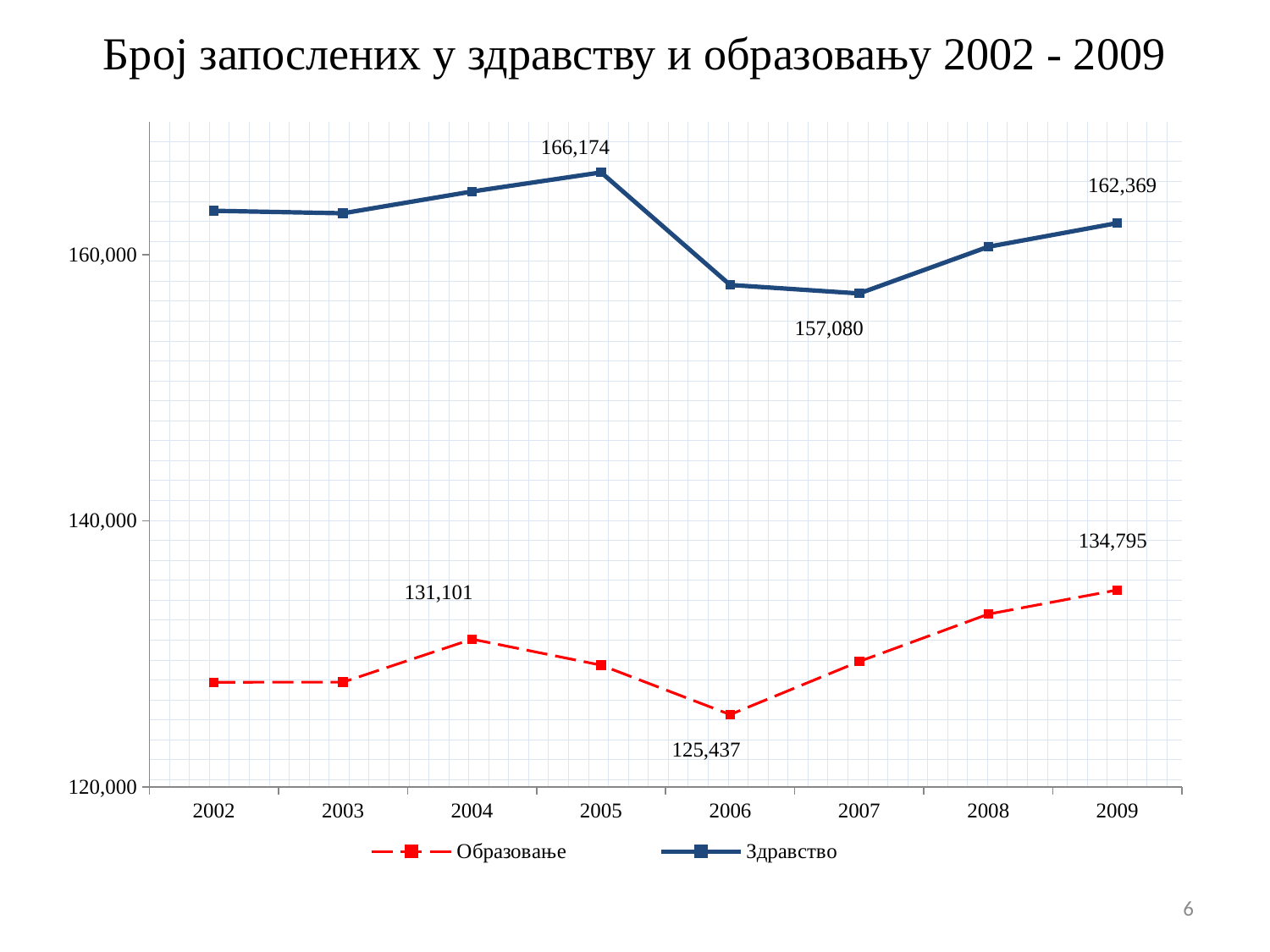
How many series does the legend list? 2 What is the value for Здравство in 2005? 166,174 What is the value for Здравство in 2007? 157,080 What is the value for Образовање in 2006? 125,437 How many years are shown on the x axis? 8 What type of chart is shown on the slide? line chart What is the difference between the Здравство values in 2005 and 2007? 9,094 In which year is the Образовање series at its lowest? 2006 Which series is drawn with a red dashed line? Образовање Is the value for Здравство in 2006 greater or less than 160,000? less What is the value for Образовање in 2009? 134,795 In which year is the Здравство series at its highest? 2005